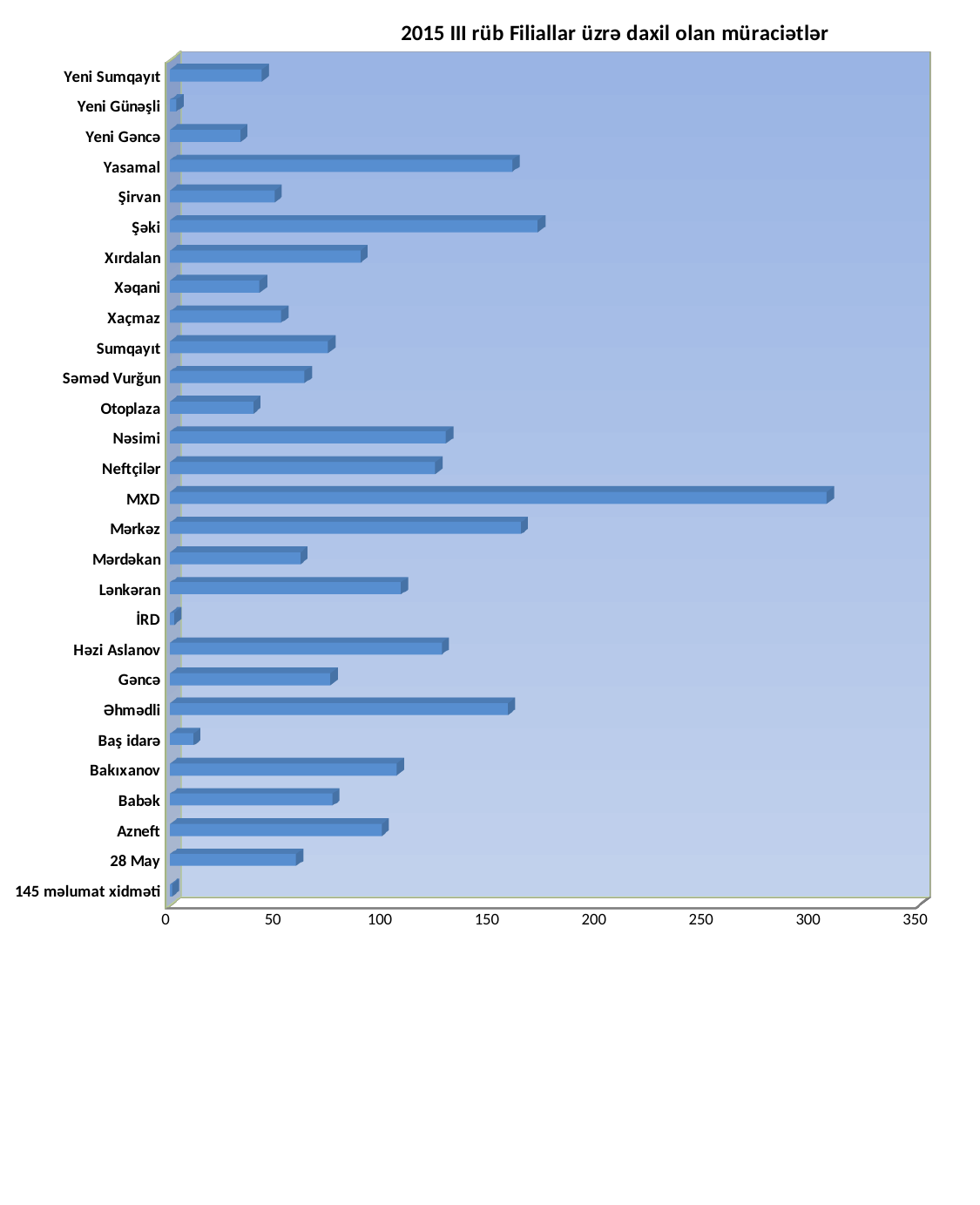
Is the value for MXD greater or less than 300? greater Which has the larger value, Şəki or Yasamal? Şəki Which branch has the lowest value in the chart? 145 məlumat xidməti Which has the larger value, Sumqayıt or Yeni Sumqayıt? Sumqayıt What kind of chart is shown on the slide? Bar chart Is the value for Baş idarə greater or less than 50? less Is the value for Şəki greater or less than 150? greater What is the title of the chart? 2015 III rüb Filiallar üzrə daxil olan müraciətlər Which branch has the highest value in the chart? MXD How many branches (categories) are plotted in the chart? 28